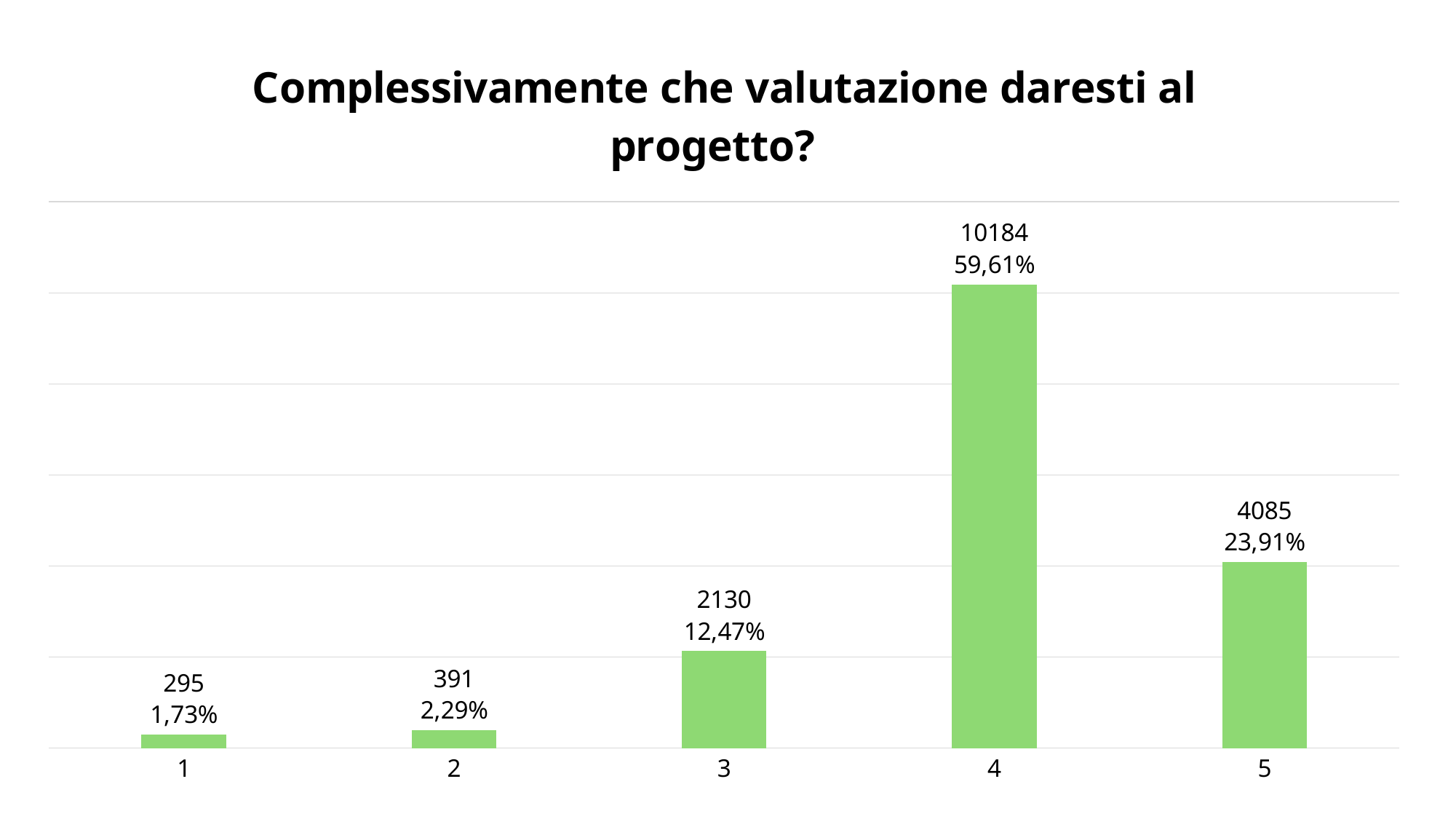
What kind of chart is this? bar chart Which rating has the highest count? 4 What is the difference between the counts for rating 4 and rating 5? 6099 What is the count for rating 4? 10184 What percentage is shown for rating 5? 23,91% What is the difference between the counts for rating 2 and rating 1? 96 What is the title of the chart? Complessivamente che valutazione daresti al progetto? Which rating has the lowest count? 1 Which has a larger count, rating 3 or rating 5? 5 What is the count for rating 1? 295 How many rating categories are shown on the x axis? 5 What percentage is shown for rating 3? 12,47%